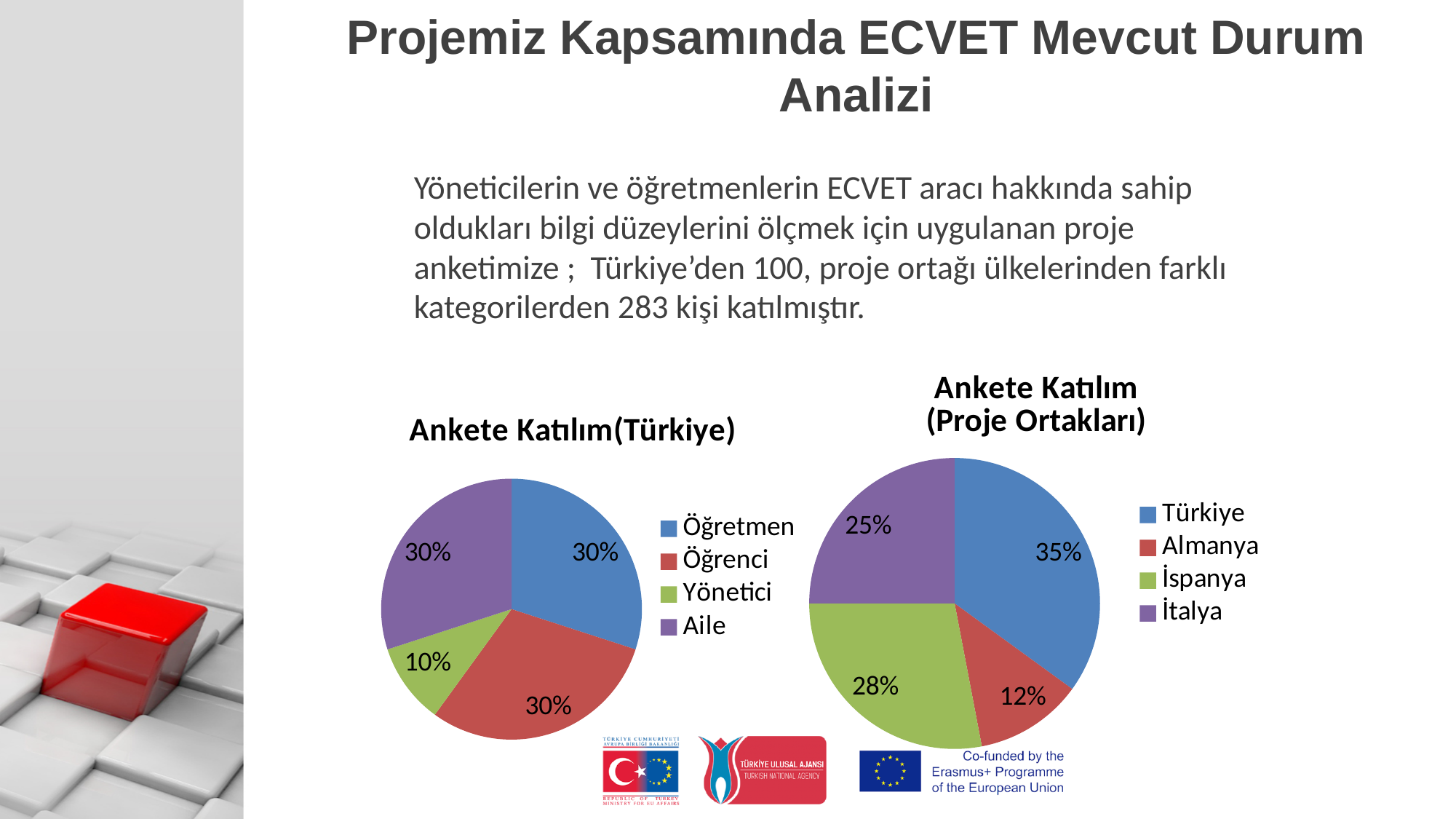
In the 'Ankete Katılım (Proje Ortakları)' chart, what is the difference between the shares of Türkiye and İtalya? 10% In the 'Ankete Katılım (Proje Ortakları)' chart, what share does İspanya have? 28% In the 'Ankete Katılım(Türkiye)' chart, how many categories does the legend list? 4 What kind of chart is 'Ankete Katılım(Türkiye)'? Pie chart In the 'Ankete Katılım (Proje Ortakları)' chart, what colour is the İtalya slice? Purple In the 'Ankete Katılım (Proje Ortakları)' chart, which country has the largest slice? Türkiye In the 'Ankete Katılım (Proje Ortakları)' chart, what share does Almanya have? 12% In the 'Ankete Katılım (Proje Ortakları)' chart, which is larger, the share for İspanya or the share for İtalya? İspanya In the 'Ankete Katılım(Türkiye)' chart, which category has the smallest slice? Yönetici In the 'Ankete Katılım (Proje Ortakları)' chart, which country has the smallest slice? Almanya In the 'Ankete Katılım(Türkiye)' chart, what share does Öğretmen have? 30% In the 'Ankete Katılım(Türkiye)' chart, what share does Yönetici have? 10%